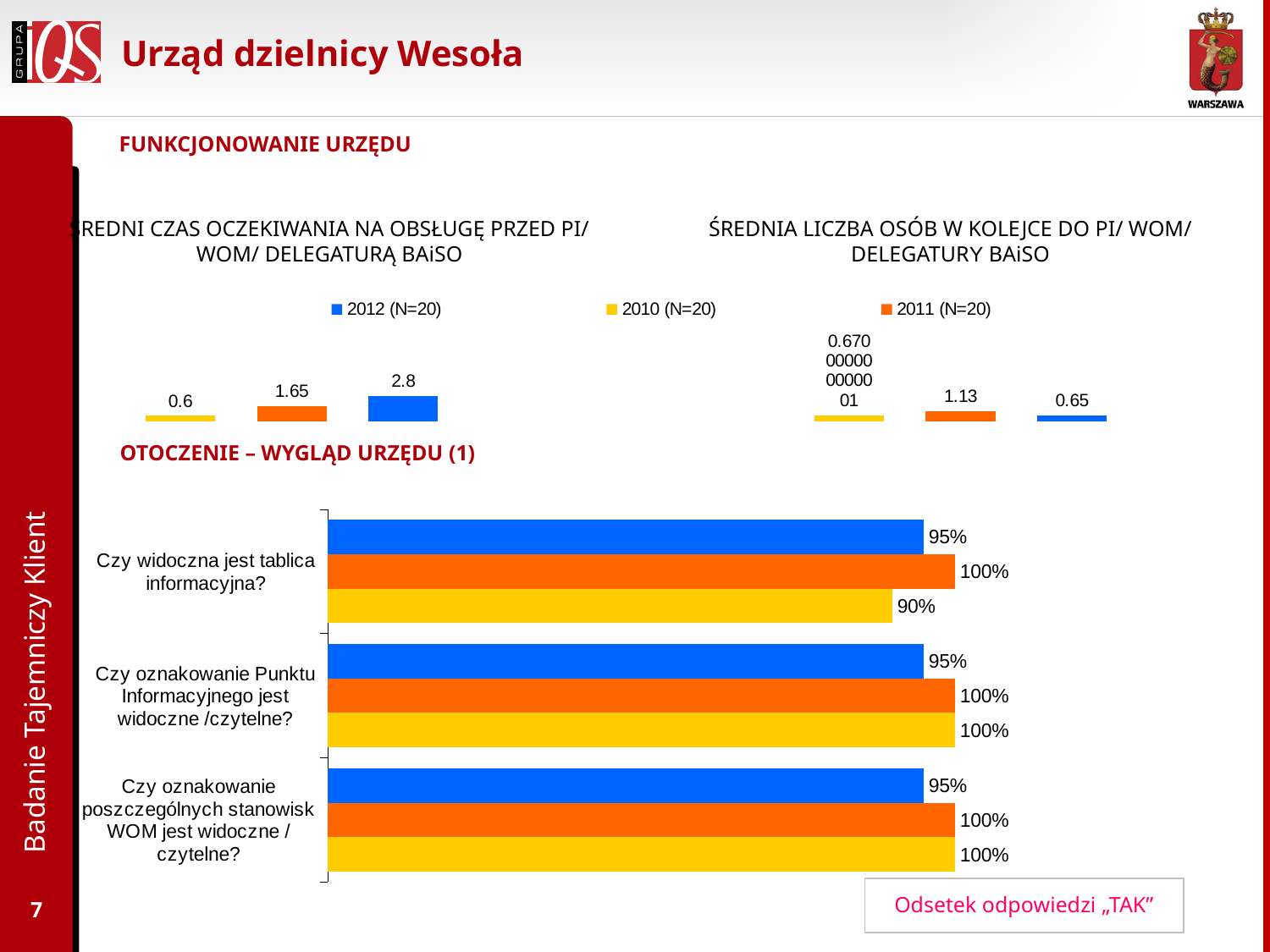
In the chart titled 'ŚREDNI CZAS OCZEKIWANIA NA OBSŁUGĘ PRZED PI/ WOM/ DELEGATURĄ BAiSO', which year has the highest value? 2012 (N=20) In the chart titled 'ŚREDNI CZAS OCZEKIWANIA NA OBSŁUGĘ PRZED PI/ WOM/ DELEGATURĄ BAiSO', what is the value for 2012 (N=20)? 2.8 In the chart titled 'ŚREDNI CZAS OCZEKIWANIA NA OBSŁUGĘ PRZED PI/ WOM/ DELEGATURĄ BAiSO', what is the value for 2010 (N=20)? 0.6 In the bottom chart under 'OTOCZENIE – WYGLĄD URZĘDU (1)', how many question categories are shown on the vertical axis? 3 In the chart titled 'ŚREDNIA LICZBA OSÓB W KOLEJCE DO PI/ WOM/ DELEGATURY BAiSO', which year has the highest value? 2011 (N=20) In the bottom chart under 'OTOCZENIE – WYGLĄD URZĘDU (1)', what is the value of the yellow bar for 'Czy widoczna jest tablica informacyjna?'? 90% In the chart titled 'ŚREDNIA LICZBA OSÓB W KOLEJCE DO PI/ WOM/ DELEGATURY BAiSO', what is the value for 2011 (N=20)? 1.13 In the chart titled 'ŚREDNI CZAS OCZEKIWANIA NA OBSŁUGĘ PRZED PI/ WOM/ DELEGATURĄ BAiSO', what is the difference between the 2012 value and the 2011 value? 1.15 In the chart titled 'ŚREDNIA LICZBA OSÓB W KOLEJCE DO PI/ WOM/ DELEGATURY BAiSO', what is the value for 2012 (N=20)? 0.65 How many series does the legend above the top two charts list? 3 What kind of chart is the bottom chart under 'OTOCZENIE – WYGLĄD URZĘDU (1)'? Bar chart In the bottom chart under 'OTOCZENIE – WYGLĄD URZĘDU (1)', what is the value of the blue bar for 'Czy oznakowanie Punktu Informacyjnego jest widoczne /czytelne?'? 95%